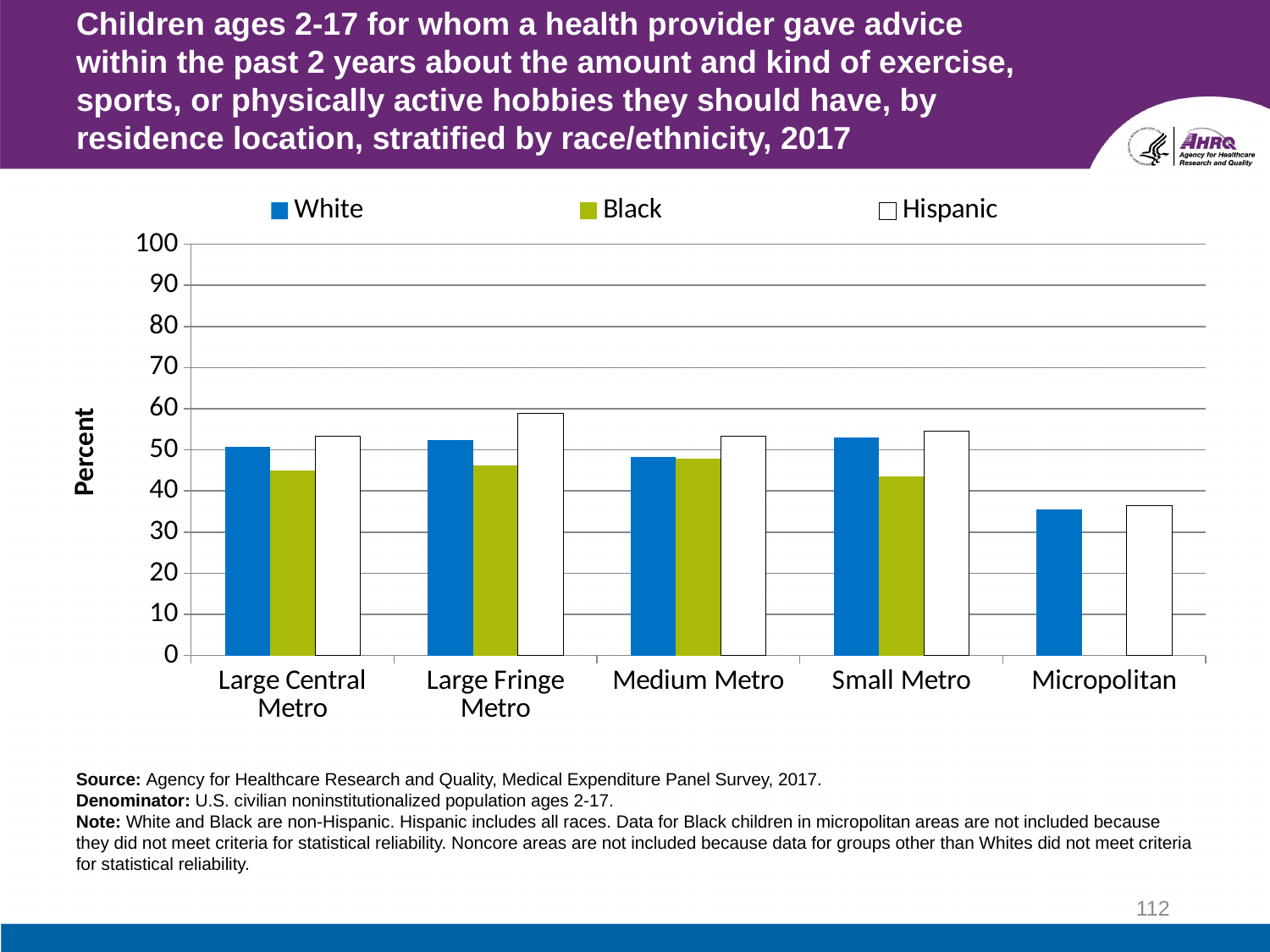
How many series does the legend list? 3 Which residence location has the lowest value for White children? Micropolitan What is the label on the y axis of the chart? Percent Is the value for White children in Micropolitan areas greater or less than 40? less Which residence location has the highest value for Hispanic children? Large Fringe Metro In Small Metro areas, which is larger: the value for White children or for Black children? White How many residence location categories are shown on the x axis? 5 Is the value for Black children in Large Central Metro areas greater or less than 50? less What kind of chart is shown on the slide? bar chart In Large Fringe Metro areas, which is larger: the value for Black children or for Hispanic children? Hispanic Is the value for Black children in Small Metro areas greater or less than 50? less